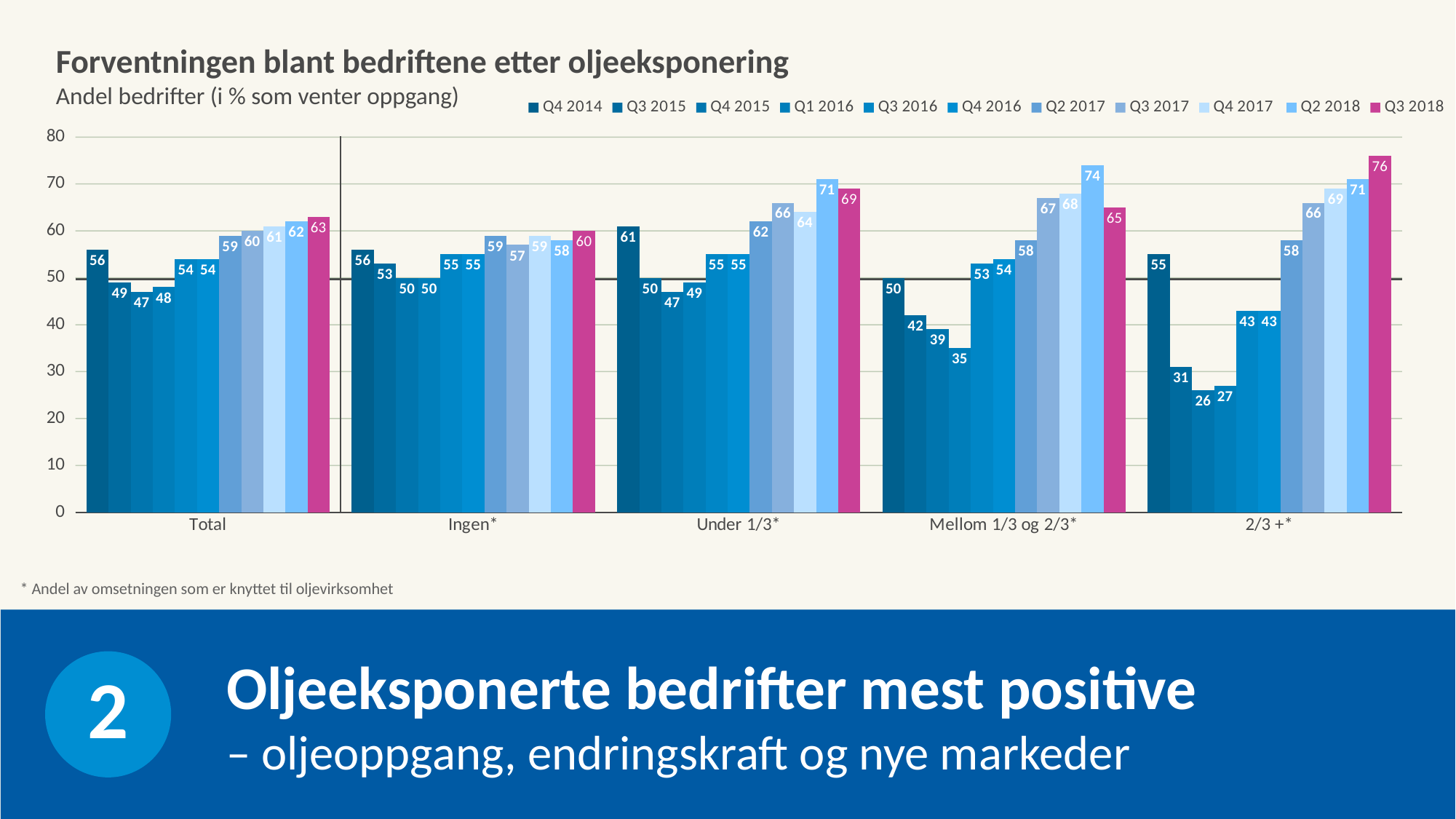
Which is larger for Q2 2018: the Total category or the Ingen* category? Total What is the value for Q4 2014 in the Total category? 56 What is the title of the chart? Forventningen blant bedriftene etter oljeeksponering How many categories are shown on the x axis? 5 What is the value for Q3 2018 in the 2/3 +* category? 76 How many series does the legend list? 11 What kind of chart is shown on the slide? Bar chart In the Total category, do the values rise or fall from Q4 2015 to Q3 2018? Rise Which category has the highest value for Q3 2018? 2/3 +* What is the value for Q1 2016 in the Mellom 1/3 og 2/3* category? 35 Which category has the lowest value for Q4 2015? 2/3 +* What is the difference between the Q3 2018 and Q4 2014 values in the 2/3 +* category? 21